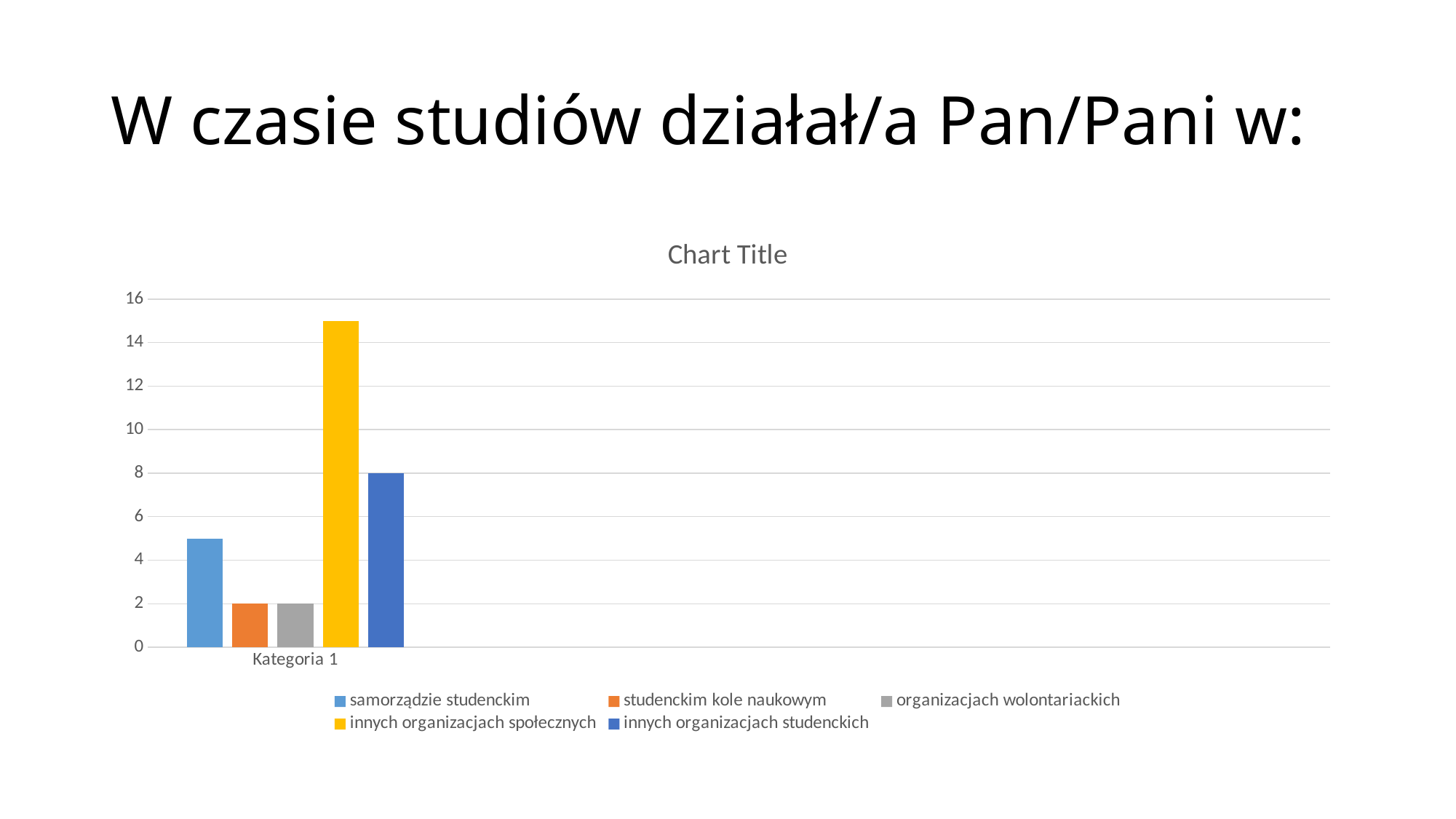
How many series does the legend list? 5 How many categories are shown on the x axis? 1 Which is larger: the value for 'samorządzie studenckim' or the value for 'innych organizacjach studenckich'? innych organizacjach studenckich Is the value for 'innych organizacjach społecznych' greater or less than 14? greater What is the value for 'innych organizacjach studenckich'? 8 What is the difference between the value for 'innych organizacjach studenckich' and the value for 'studenckim kole naukowym'? 6 What is the value for 'studenckim kole naukowym'? 2 What is the value for 'organizacjach wolontariackich'? 2 What is the label of the category on the x axis? Kategoria 1 What type of chart is shown on the slide? bar chart Which series has the highest value? innych organizacjach społecznych Is the value for 'samorządzie studenckim' greater or less than 6? less